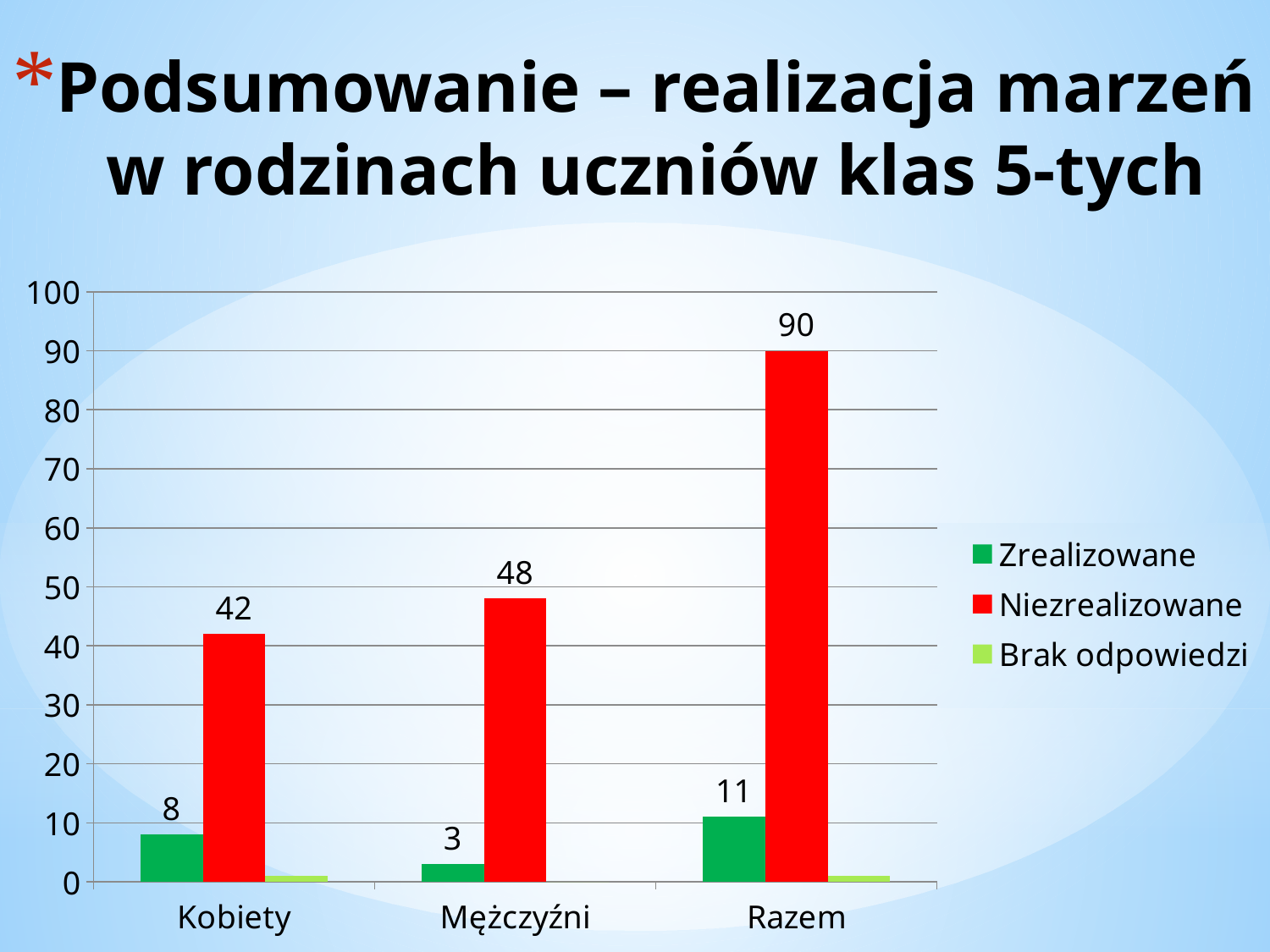
What kind of chart is shown on the slide? bar chart Which is larger: the Zrealizowane value for Kobiety or for Mężczyźni? Kobiety What is the Niezrealizowane value for Razem? 90 How many series does the legend list? 3 How many categories are shown on the x axis? 3 Is the Brak odpowiedzi value for Kobiety greater or less than 10? less What is the Zrealizowane value for Razem? 11 What is the difference between the Niezrealizowane values for Mężczyźni and Kobiety? 6 What is the Zrealizowane value for Mężczyźni? 3 Which category has the highest Niezrealizowane value? Razem What is the Niezrealizowane value for Kobiety? 42 Which category has the lowest Zrealizowane value? Mężczyźni